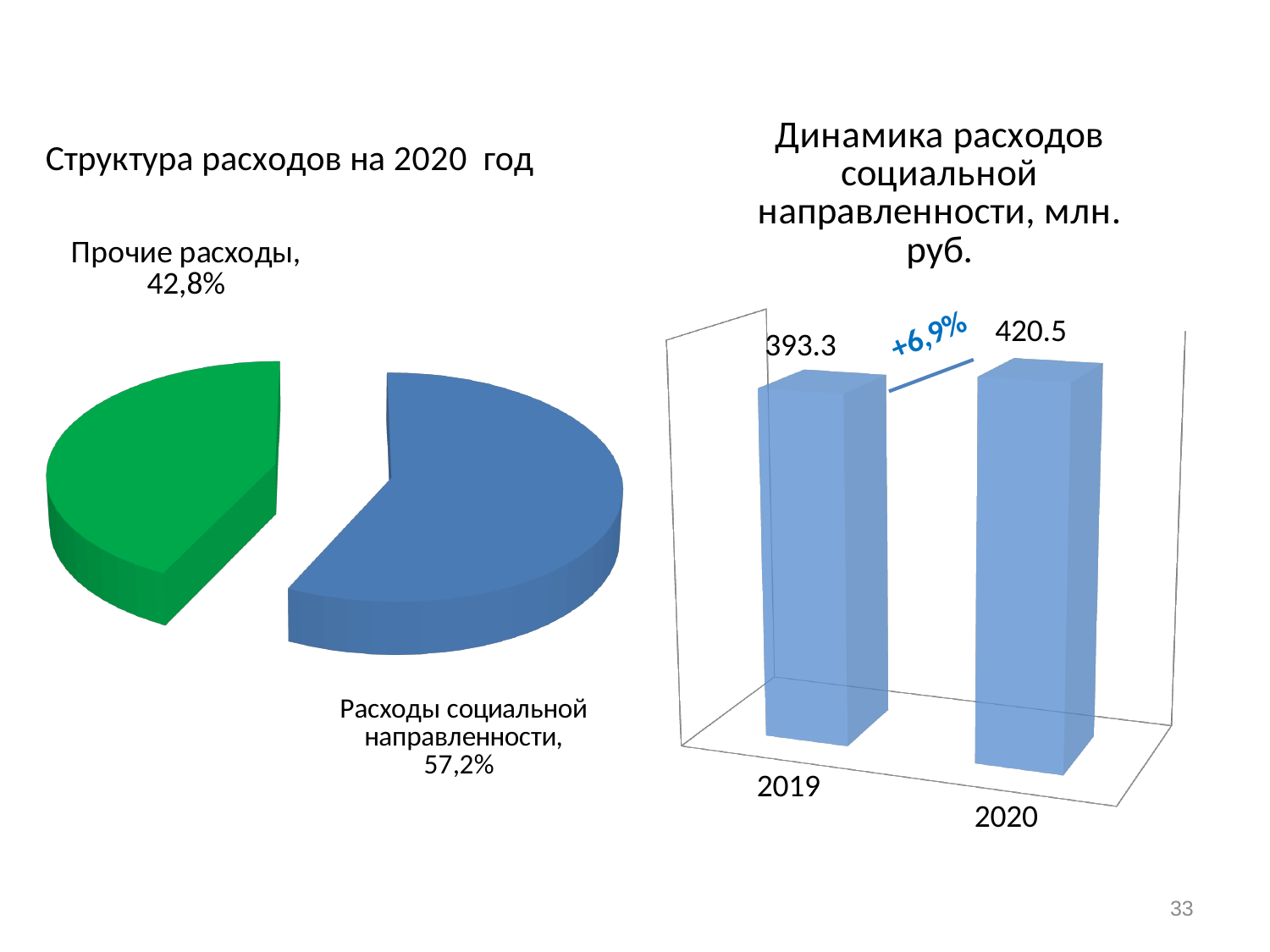
In the chart 'Динамика расходов социальной направленности, млн. руб.', what is the value for 2019? 393.3 What type of chart is the one on the left of the slide? Pie chart In the chart 'Динамика расходов социальной направленности, млн. руб.', what is the difference between the 2020 and 2019 values? 27.2 In the pie chart 'Структура расходов на 2020 год', what colour is the 'Прочие расходы' slice? Green What type of chart is the one on the right of the slide? Bar chart In the pie chart 'Структура расходов на 2020 год', how many slices are there? 2 In the pie chart 'Структура расходов на 2020 год', what share is shown for 'Прочие расходы'? 42,8% In the chart 'Динамика расходов социальной направленности, млн. руб.', what is the value for 2020? 420.5 In the pie chart 'Структура расходов на 2020 год', what share is shown for 'Расходы социальной направленности'? 57,2% In the chart 'Динамика расходов социальной направленности, млн. руб.', which year has the higher value? 2020 In the chart 'Динамика расходов социальной направленности, млн. руб.', do the values rise or fall from 2019 to 2020? Rise In the pie chart 'Структура расходов на 2020 год', which slice is the largest? Расходы социальной направленности